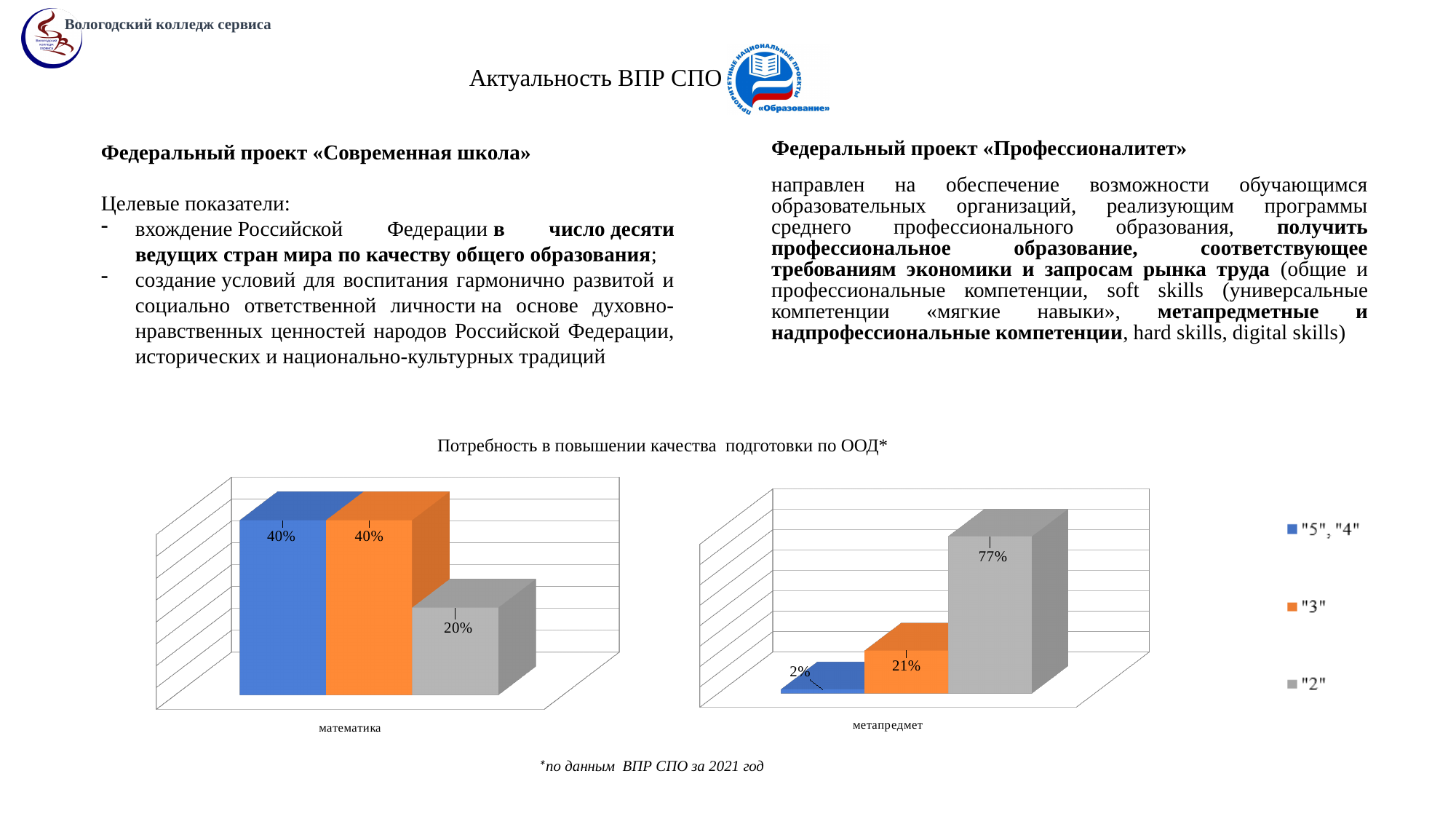
In the right chart (метапредмет), what is the value for the "5", "4" series? 2% How many series does the legend list? 3 Which is larger: the "2" value in the left chart (математика) or the "2" value in the right chart (метапредмет)? метапредмет In the right chart (метапредмет), what is the difference between the "2" value and the "3" value? 56% In the right chart (метапредмет), which series has the highest value? "2" In the left chart (математика), what is the value for the "3" series? 40% In the left chart (математика), which series has the lowest value? "2" In the right chart (метапредмет), which series has the lowest value? "5", "4" In the right chart (метапредмет), what is the value for the "3" series? 21% In the left chart (математика), what is the difference between the "3" value and the "2" value? 20% In the left chart (математика), what is the value for the "2" series? 20% In the right chart (метапредмет), what is the value for the "2" series? 77%